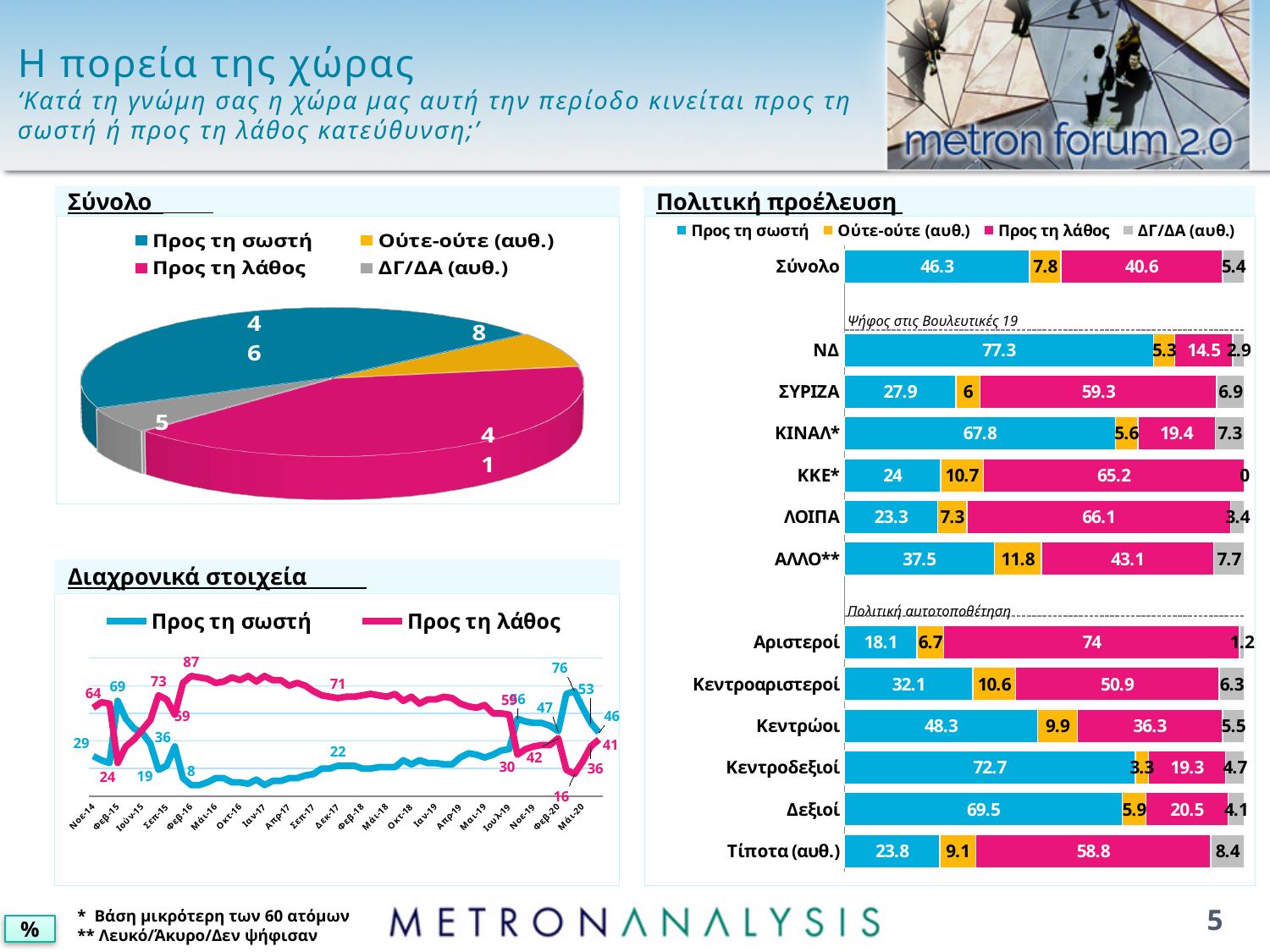
In the 'Πολιτική προέλευση' chart, what is the 'Προς τη σωστή' value for ΝΔ? 77.3 In the 'Πολιτική προέλευση' chart, what is the 'Προς τη λάθος' value for ΣΥΡΙΖΑ? 59.3 In the 'Πολιτική προέλευση' chart, for Κεντρώοι, which is larger: 'Προς τη σωστή' or 'Προς τη λάθος'? Προς τη σωστή In the 'Διαχρονικά στοιχεία' chart, what is the highest value labelled on the 'Προς τη λάθος' line? 87 In the 'Πολιτική προέλευση' chart, which category has the highest 'Προς τη σωστή' value? ΝΔ In the 'Πολιτική προέλευση' chart, which category has the lowest 'Προς τη σωστή' value? Αριστεροί In the 'Πολιτική προέλευση' chart, what is the total of the four segments in the ΝΔ bar? 100 In the 'Πολιτική προέλευση' chart, what is the difference between the 'Προς τη σωστή' values for ΝΔ and ΣΥΡΙΖΑ? 49.4 In the 'Πολιτική προέλευση' chart, what is the 'Ούτε-ούτε (αυθ.)' value for ΚΚΕ*? 10.7 What kind of chart is the 'Διαχρονικά στοιχεία' chart? Line chart What kind of chart is the 'Πολιτική προέλευση' chart? Bar chart How many series does the legend of the 'Πολιτική προέλευση' chart list? 4